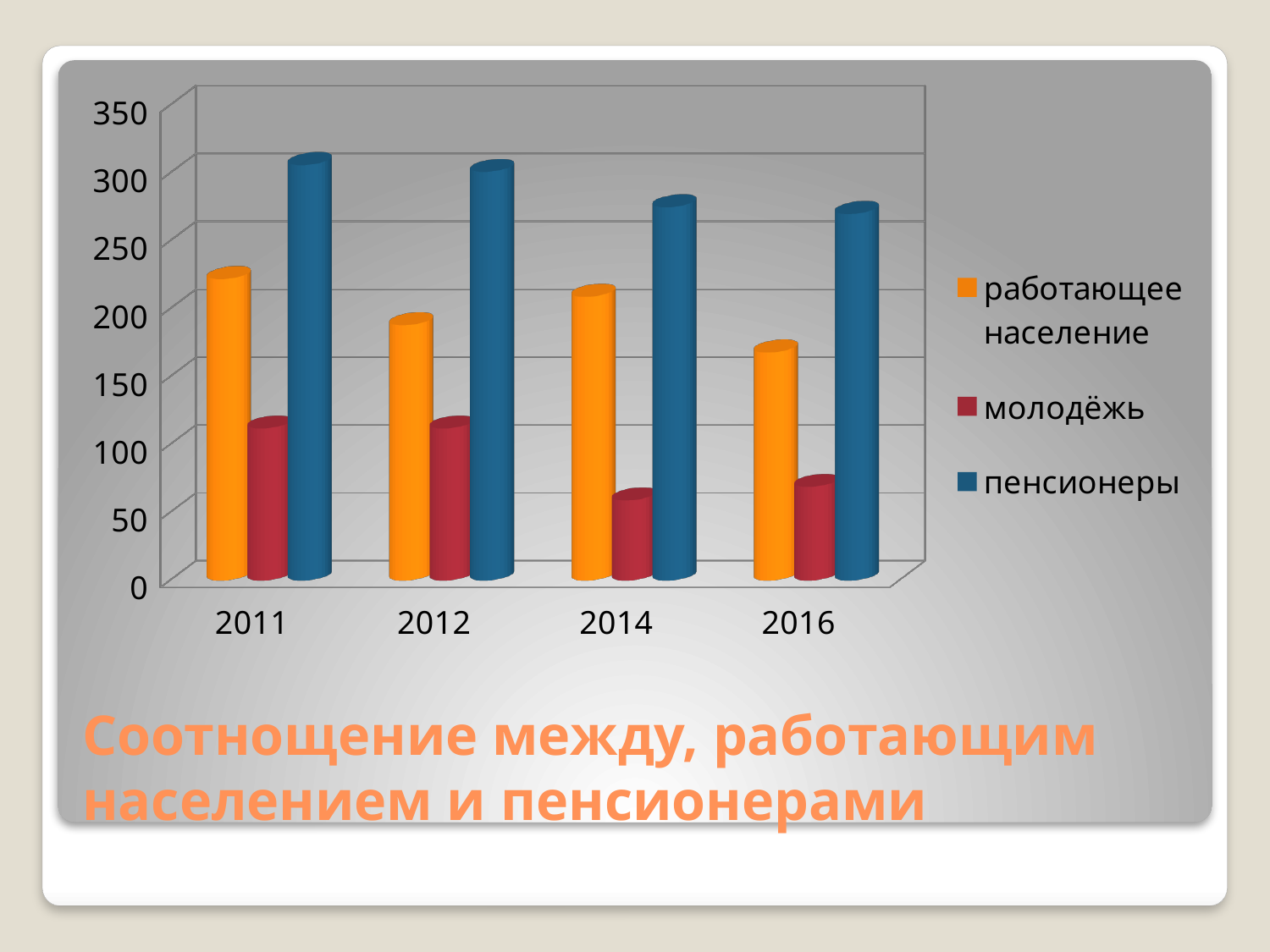
Is the value for пенсионеры in 2011 greater or less than 250? greater What is the title of the chart on the slide? Соотношение между, работающим населением и пенсионерами In which year is the value for работающее население the lowest? 2016 How many years are shown on the x axis of the chart? 4 Is the value for работающее население in 2011 greater or less than 150? greater Is the value for молодёжь in 2014 greater or less than 100? less Which series is shown in blue in the chart? пенсионеры In 2014, which is larger: пенсионеры or работающее население? пенсионеры What kind of chart is shown on the slide? bar chart How many series does the chart legend list? 3 In which year is the value for работающее население the highest? 2011